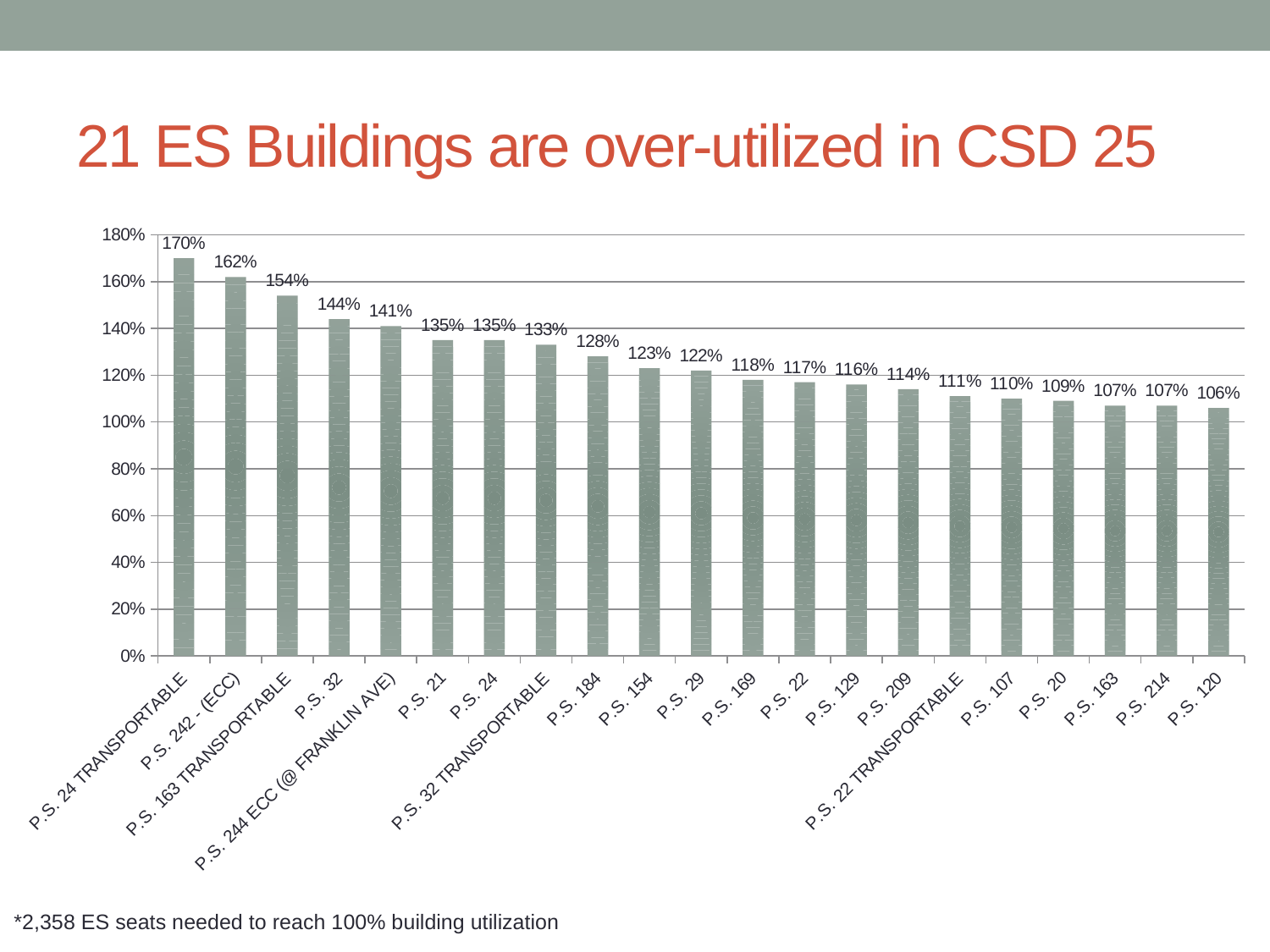
What kind of chart is shown on the slide? Bar chart What is the utilization value for P.S. 32? 144% Which building has the highest utilization? P.S. 24 TRANSPORTABLE Which building has the lowest utilization? P.S. 120 What is the utilization value for P.S. 184? 128% Which has a higher utilization, P.S. 154 or P.S. 169? P.S. 154 How many buildings are shown in the chart? 21 Is the value for P.S. 244 ECC (@ FRANKLIN AVE) greater or less than 120%? greater What is the difference between the utilization of P.S. 163 TRANSPORTABLE and P.S. 163? 47% Do the values rise or fall from left to right along the x axis? Fall What is the utilization value for P.S. 209? 114% What is the difference between the utilization of P.S. 24 TRANSPORTABLE and P.S. 242 - (ECC)? 8%